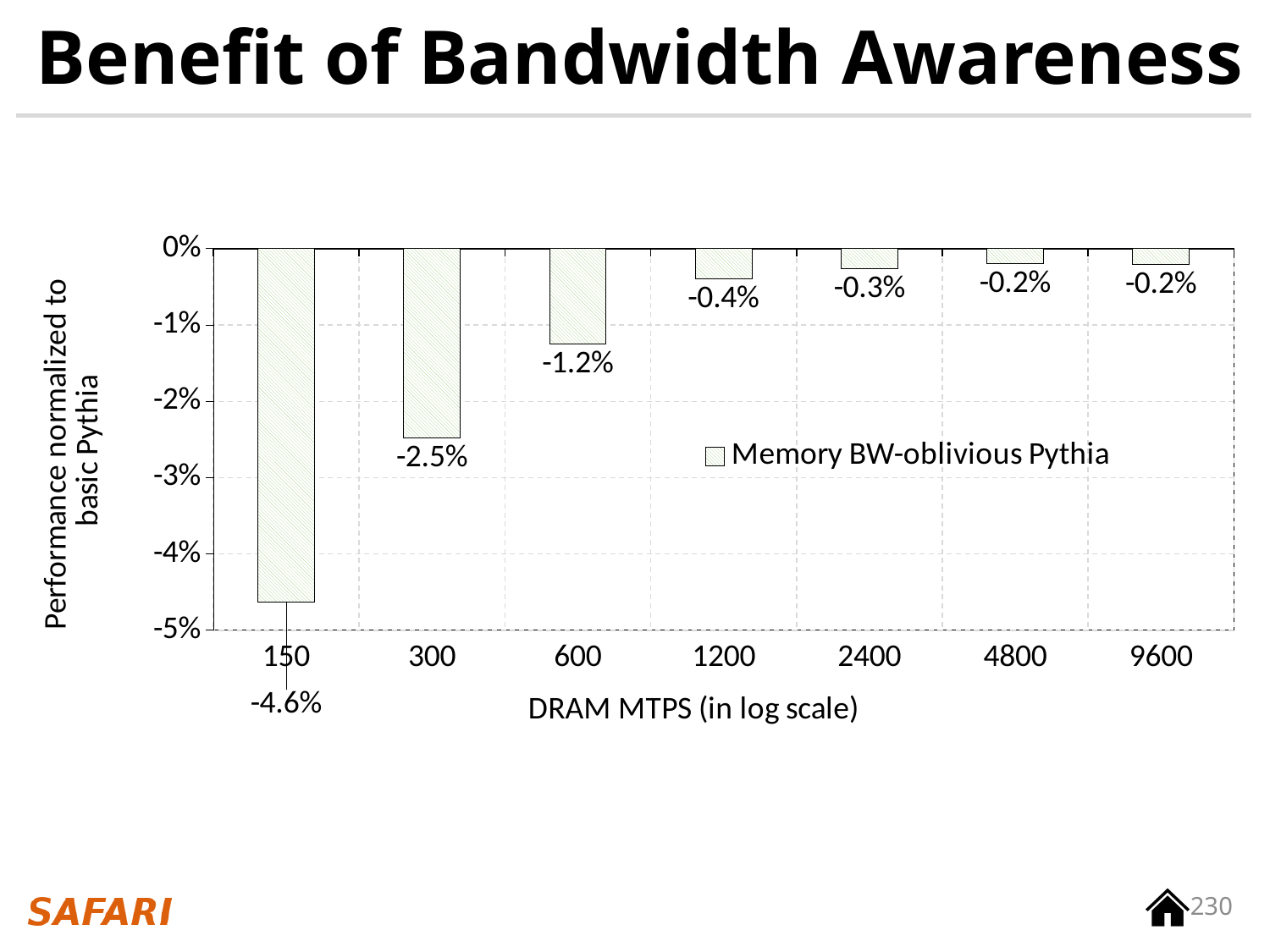
Which has a larger performance loss, DRAM MTPS 300 or 600? 300 What is the value for DRAM MTPS 150? -4.6% What kind of chart is shown on the slide? bar chart What is the x-axis title of the chart? DRAM MTPS (in log scale) What is the series name listed in the legend? Memory BW-oblivious Pythia Which DRAM MTPS category has the lowest (most negative) value? 150 What is the difference between the values for DRAM MTPS 150 and 300? 2.1% Do the values become less negative or more negative as DRAM MTPS increases along the x axis? less negative What is the value for DRAM MTPS 2400? -0.3% How many DRAM MTPS categories are shown on the x axis? 7 What is the value for DRAM MTPS 600? -1.2% How many series does the legend list? 1